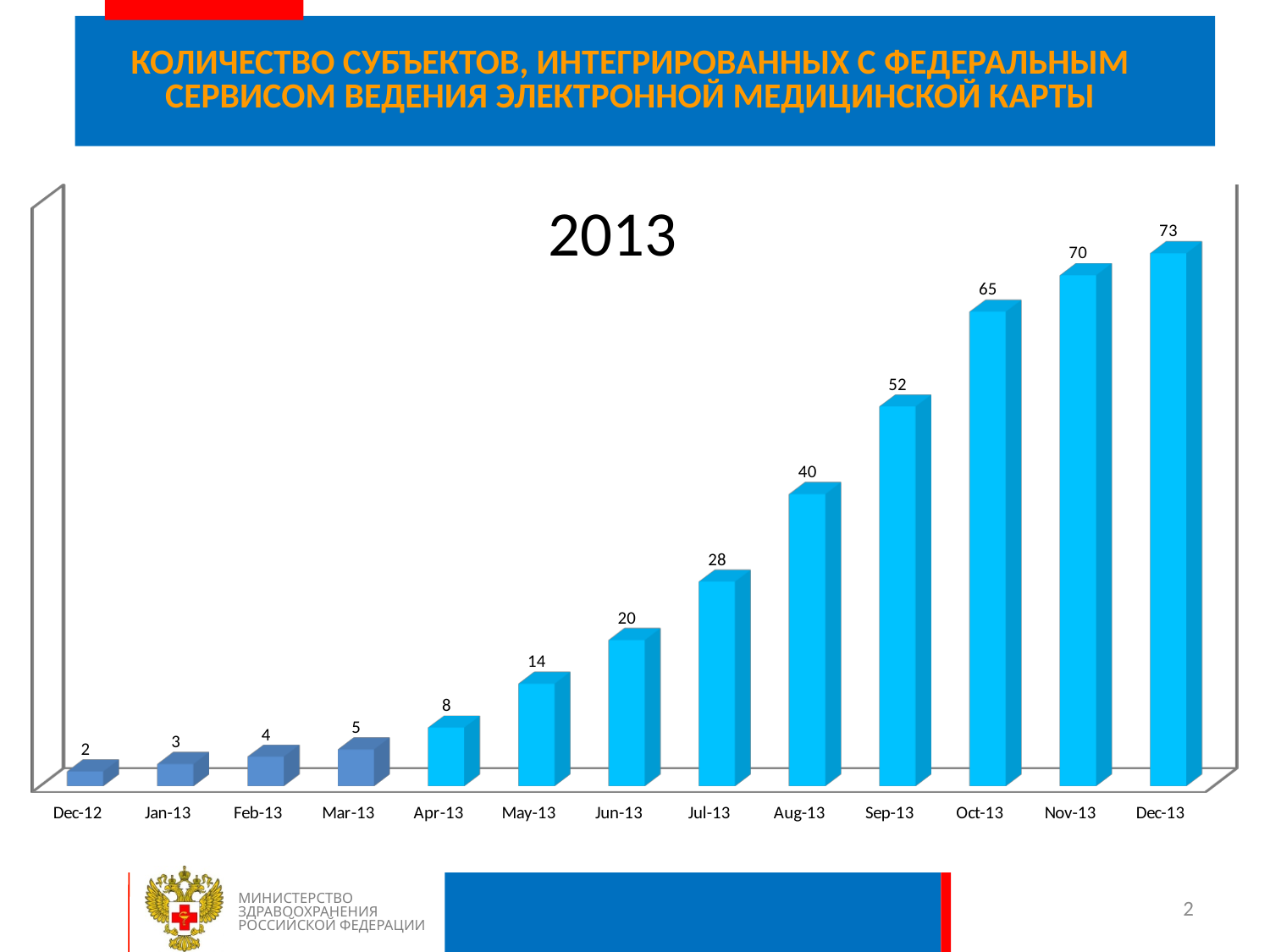
What is the difference between the values for Sep-13 and Aug-13? 12 What is the value for Aug-13? 40 Which is larger, the value for Jul-13 or the value for Jun-13? Jul-13 Which month has the highest value? Dec-13 Which month has the lowest value? Dec-12 What is the value for Dec-13? 73 What is the difference between the values for Dec-13 and Dec-12? 71 What kind of chart is shown on the slide? bar chart How many months are shown on the x axis? 13 What year is written as the chart's title above the bars? 2013 Do the values rise or fall from Dec-12 to Dec-13? rise What is the value for Mar-13? 5